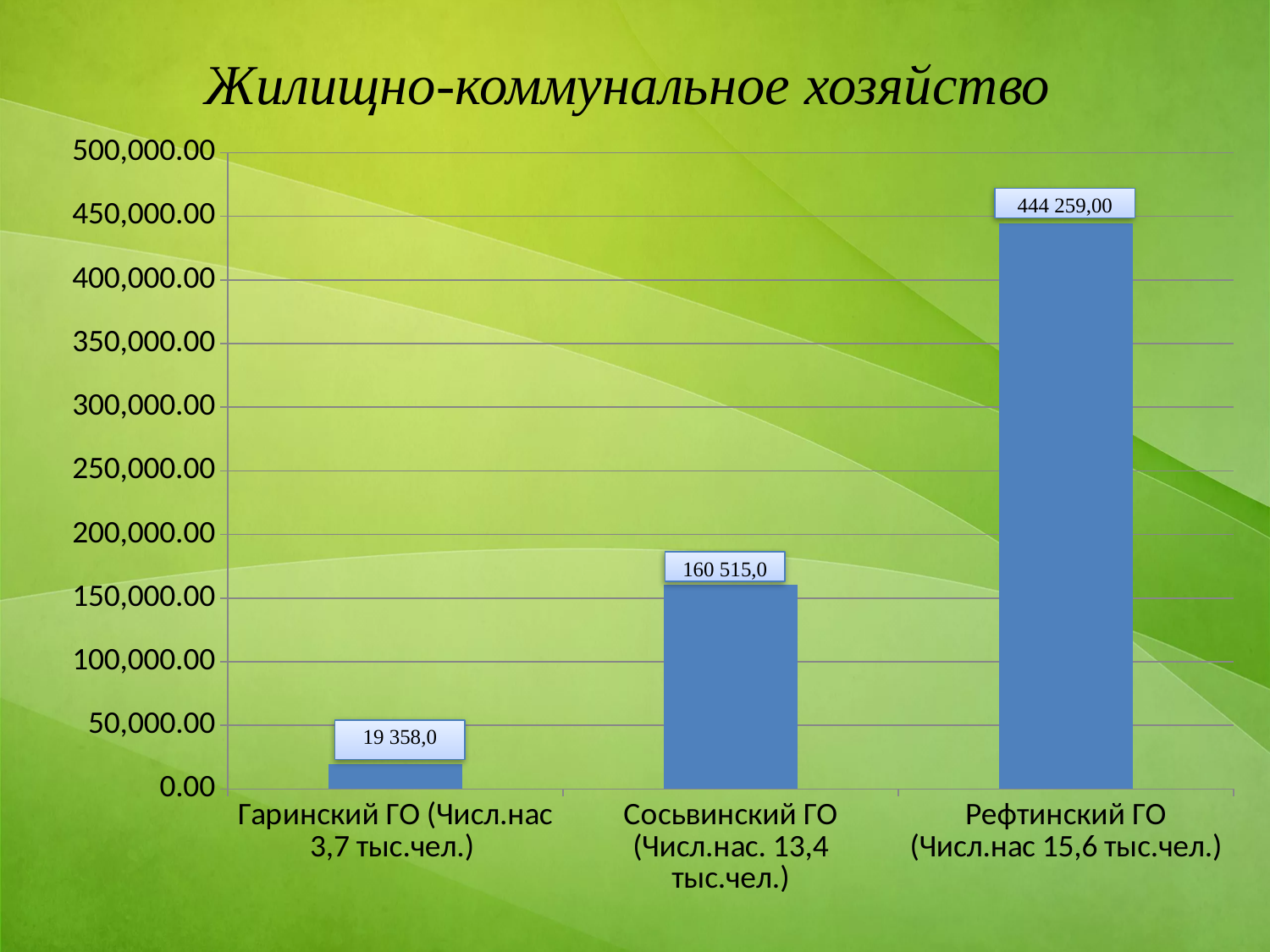
What kind of chart is shown on the slide? bar chart What is the title of the chart? Жилищно-коммунальное хозяйство What is the value for Рефтинский ГО? 444 259,00 What is the difference between the values for Сосьвинский ГО and Гаринский ГО? 141 157,0 What is the value for Сосьвинский ГО? 160 515,0 How many categories are shown in the chart? 3 Which category has the lowest value? Гаринский ГО Which category has the highest value? Рефтинский ГО What is the difference between the values for Рефтинский ГО and Сосьвинский ГО? 283 744,0 Which is larger, the value for Сосьвинский ГО or the value for Гаринский ГО? Сосьвинский ГО Is the value for Рефтинский ГО greater or less than 400,000.00? greater What is the value for Гаринский ГО? 19 358,0